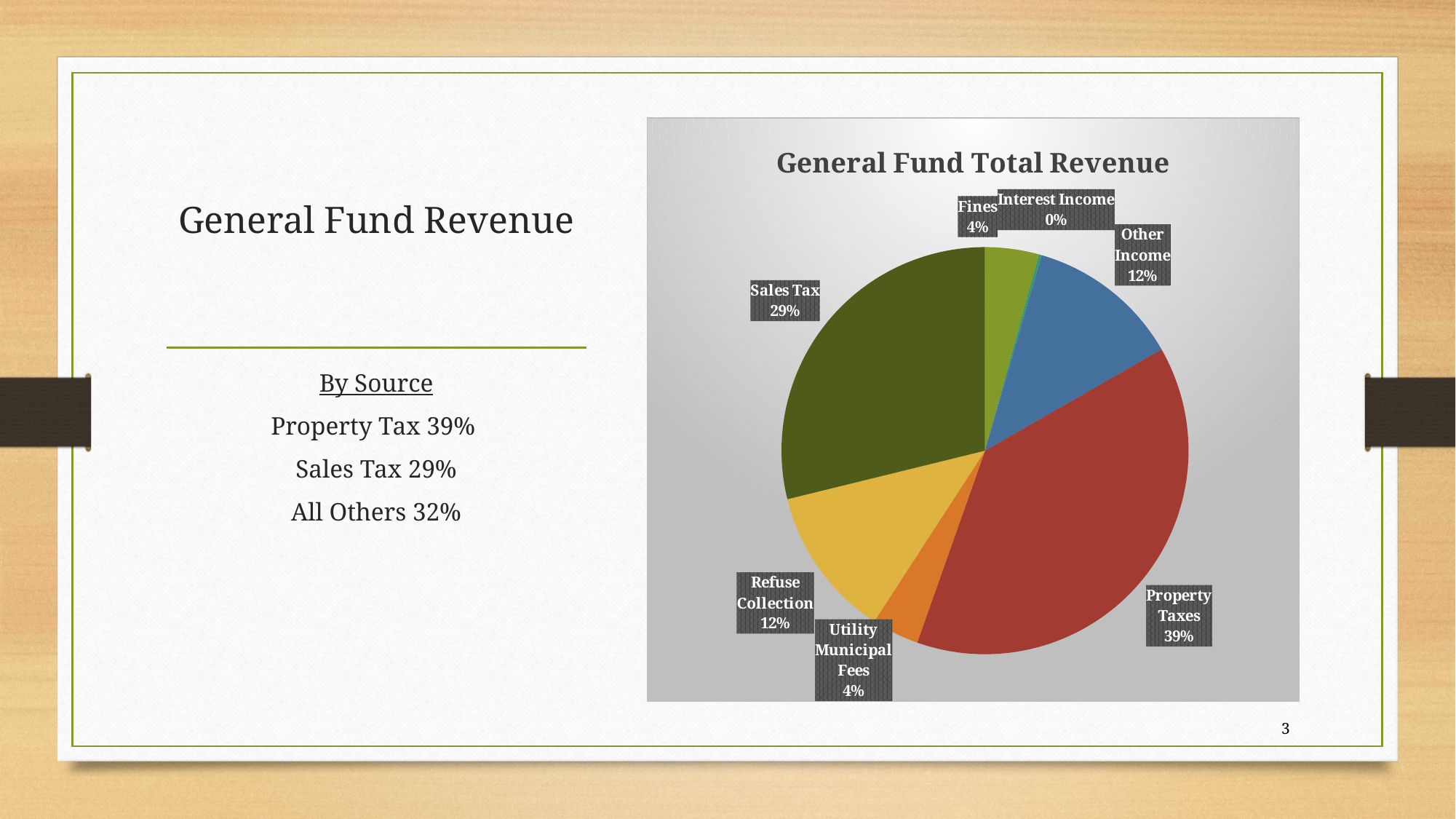
What type of chart is shown on the slide? Pie chart What percentage is shown for Interest Income in the pie chart? 0% What is the title of the chart? General Fund Total Revenue What percentage is shown for Utility Municipal Fees in the pie chart? 4% Which is larger, the share for Other Income or the share for Fines? Other Income What is the difference in percentage points between Property Taxes and Sales Tax? 10 Which revenue source has the smallest slice of the pie chart? Interest Income Which revenue source has the largest slice of the pie chart? Property Taxes How many revenue sources are shown in the pie chart? 7 What share of General Fund Total Revenue comes from Sales Tax? 29% What share of General Fund Total Revenue comes from Property Taxes? 39% What percentage is shown for Refuse Collection in the pie chart? 12%